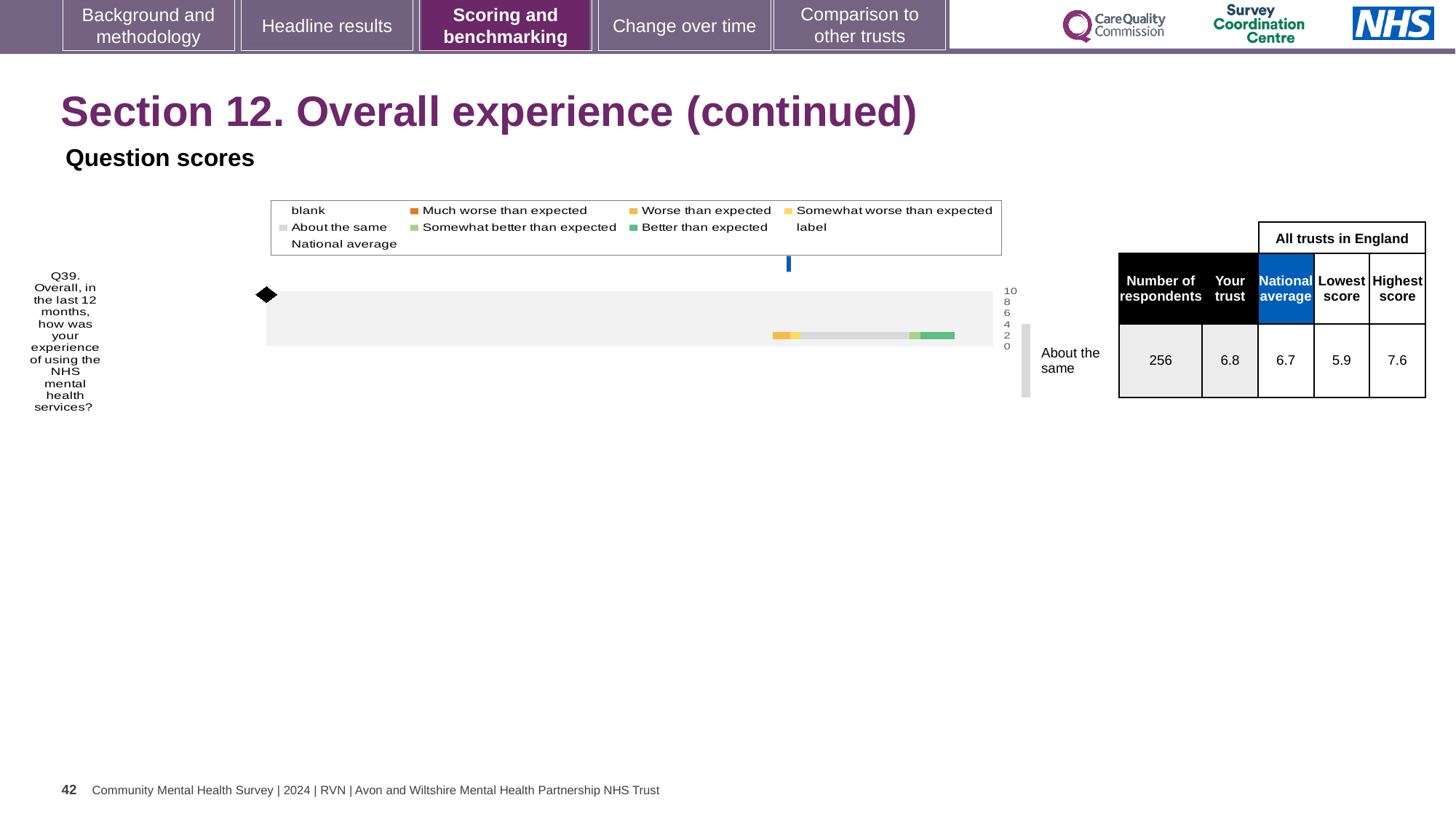
Which benchmarking category is the trust's result for Q39 labelled as on the slide? About the same What is the 'Your trust' score for Q39 shown in the table next to the chart? 6.8 What is the national average score for Q39 shown on the slide? 6.7 What is the lowest score among all trusts in England for Q39? 5.9 How many survey questions are plotted in the chart on this slide? 1 How many respondents answered Q39 for this trust? 256 For Q39, which is higher: the 'Your trust' score or the national average? Your trust What is the highest score among all trusts in England for Q39? 7.6 What colour does the legend use for 'Much worse than expected'? orange What is the difference between the highest score and the lowest score for Q39? 1.7 What kind of chart is shown for Q39 on this slide? bar chart What is the difference between the 'Your trust' score and the national average for Q39? 0.1